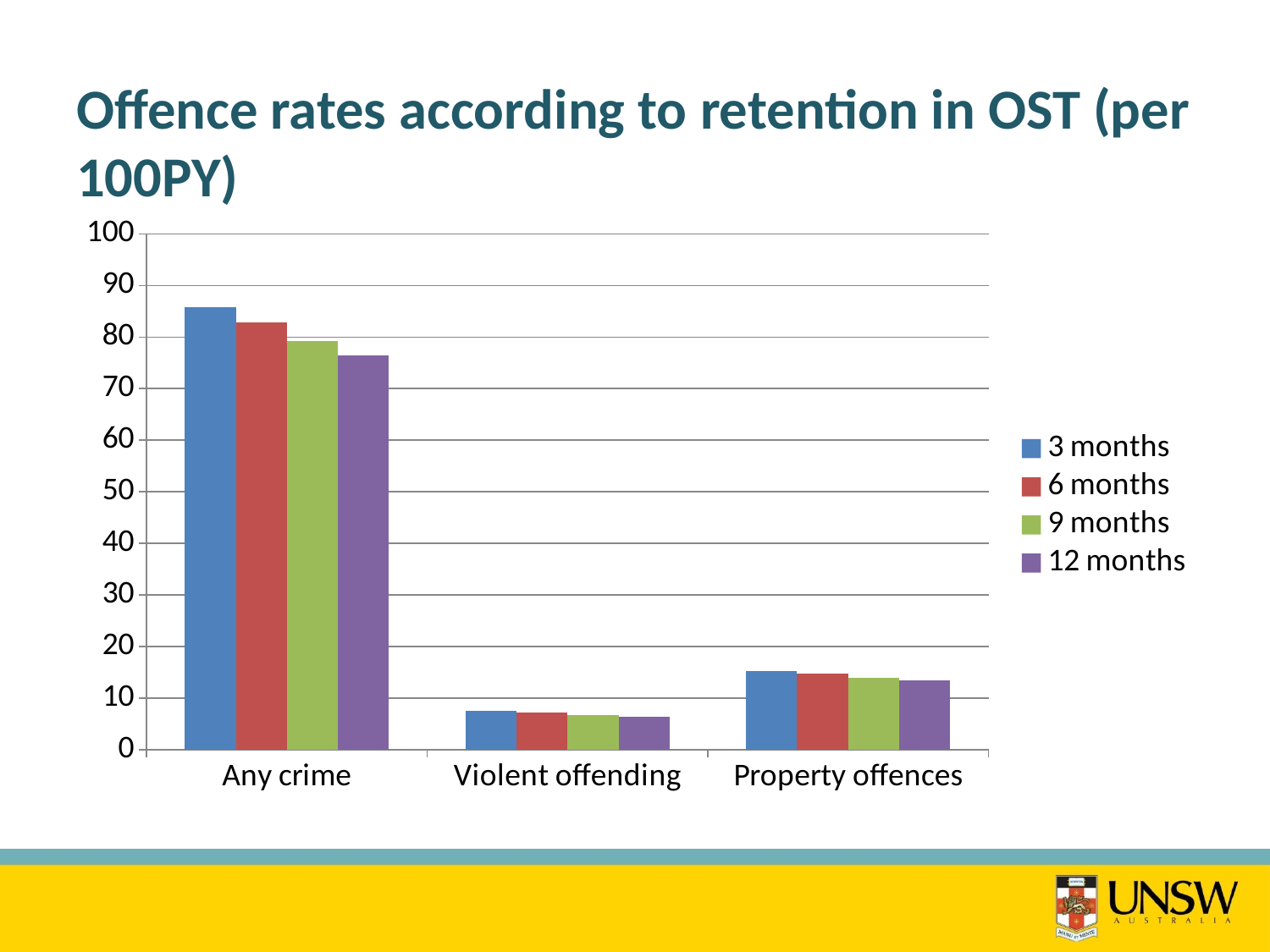
How many series does the legend list? 4 Is the value for Any crime in the 12 months series greater or less than 80? less Which series is shown in purple in the legend? 12 months Within the Any crime category, do the offence rates rise or fall as retention increases from 3 months to 12 months? Fall How many offence categories are shown on the x axis? 3 What kind of chart is shown on the slide? Bar chart Which offence category has the highest rate for the 3 months series? Any crime Is the value for Violent offending in the 3 months series greater or less than 10? less For Any crime, which is larger: the 3 months value or the 12 months value? 3 months Which offence category has the lowest rate for the 12 months series? Violent offending Is the value for Property offences in the 3 months series greater or less than 20? less